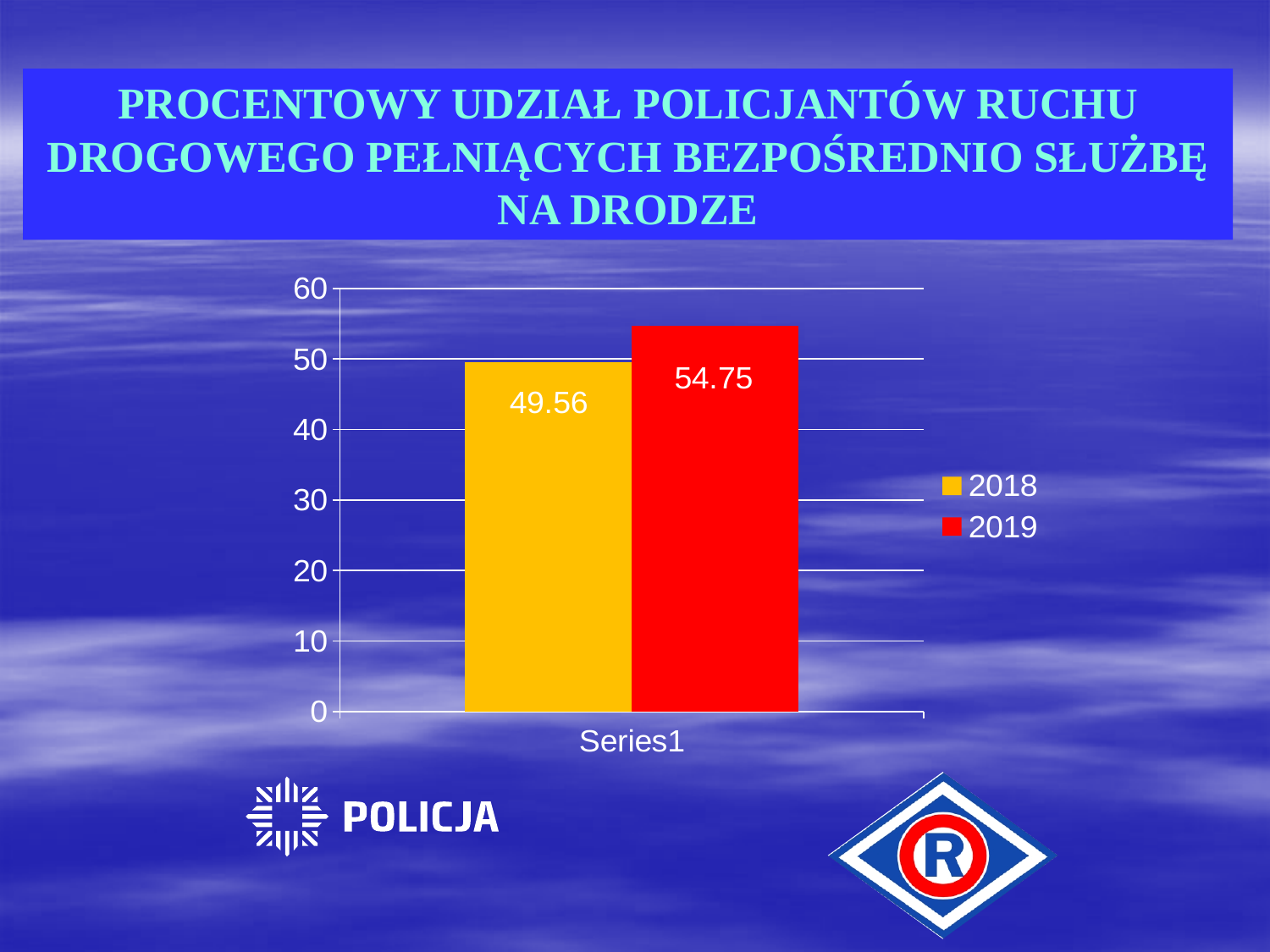
What kind of chart is shown on the slide? bar chart Which series has the highest value? 2019 What is the value for 2019? 54.75 Is the value for 2019 greater or less than 50? greater Which series has the lowest value? 2018 What is the difference between the 2019 value and the 2018 value? 5.19 Which year has the higher value, 2018 or 2019? 2019 What colour is the bar for 2019? red What is the label shown on the x axis under the bars? Series1 What is the value for 2018? 49.56 Is the value for 2018 greater or less than 50? less How many series does the legend list? 2